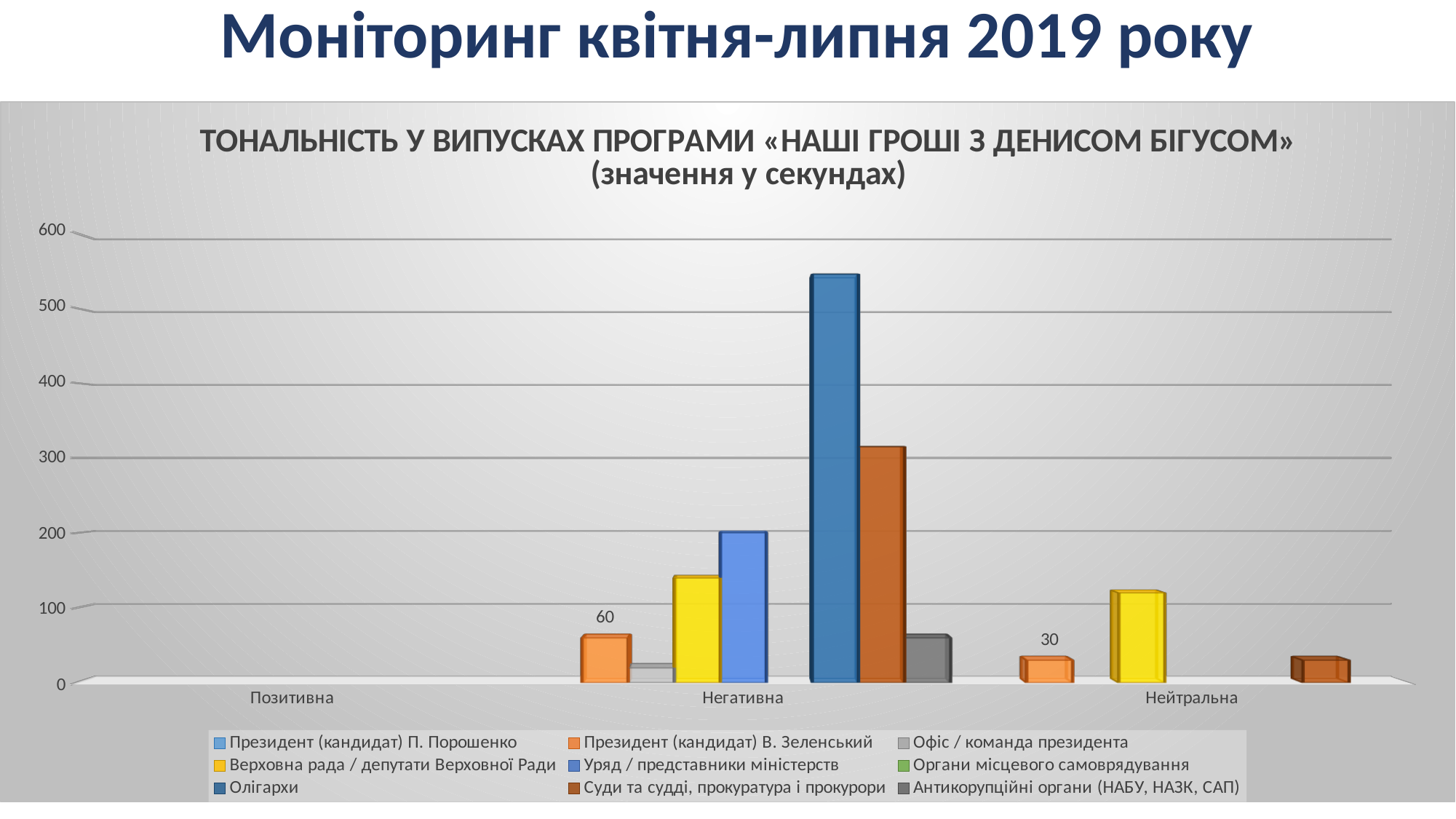
How many series does the legend list? 9 Which series has the highest bar in the Негативна category? Олігархи What is the value for Президент (кандидат) В. Зеленський in the Нейтральна category? 30 What kind of chart is shown on the slide? bar chart In the Негативна category, which is larger: the bar for Олігархи or the bar for Суди та судді, прокуратура і прокурори? Олігархи How many categories are shown on the x axis? 3 Is the value for Верховна рада / депутати Верховної Ради in the Нейтральна category greater or less than 100? greater What is the value for Президент (кандидат) В. Зеленський in the Негативна category? 60 Is the value for Суди та судді, прокуратура і прокурори in the Негативна category greater or less than 200? greater In what units are the chart values given, according to the chart title? секундах (seconds) What is the difference between the Негативна and Нейтральна values for Президент (кандидат) В. Зеленський? 30 Is the value for Олігархи in the Негативна category greater or less than 500? greater